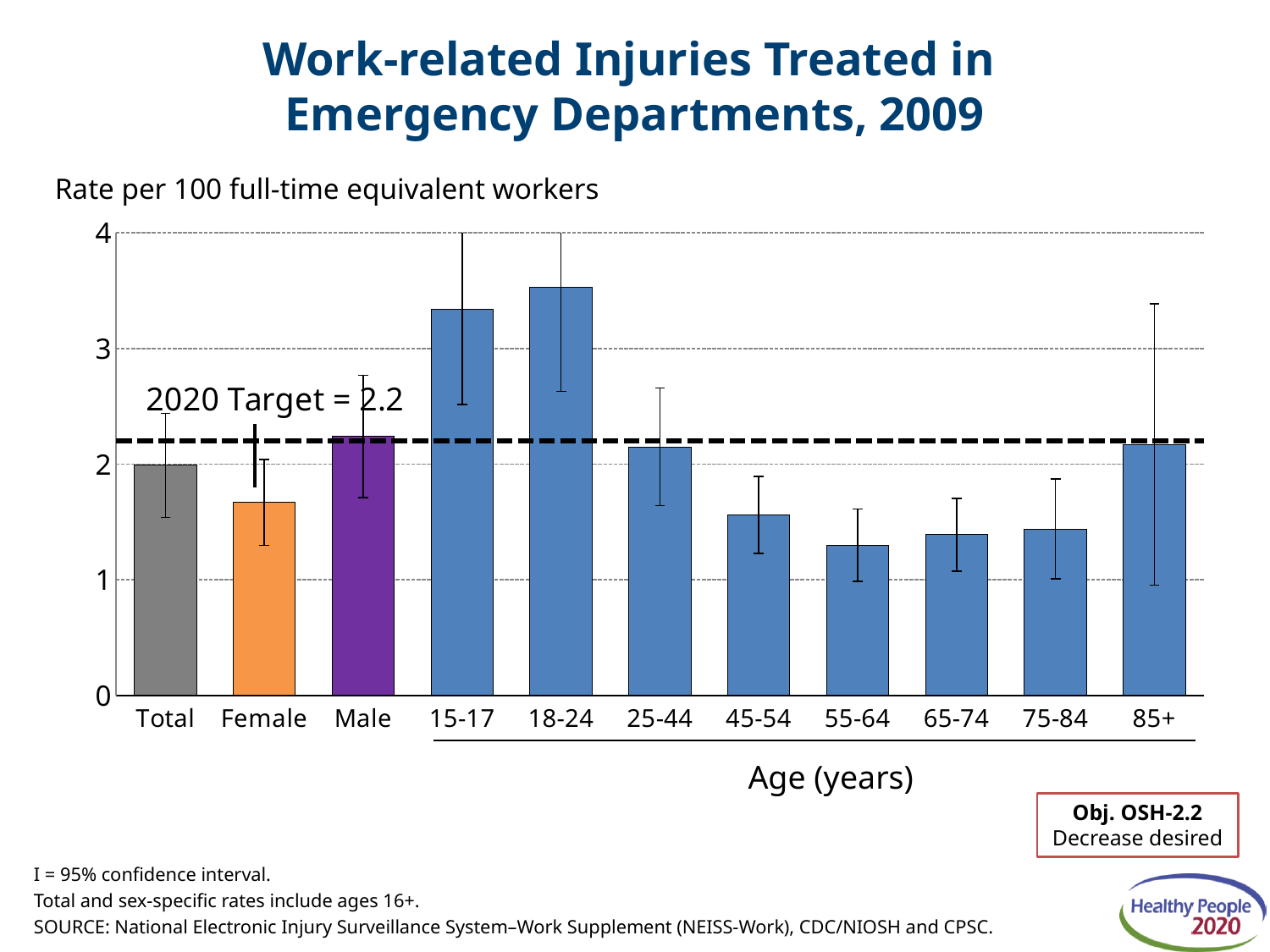
How many bars are plotted on the chart? 11 Is the value for ages 55-64 greater or less than 1? greater Is the value for Female greater or less than 2? less Which is higher, the rate for ages 15-17 or the rate for ages 25-44? 15-17 Is the value for ages 18-24 greater or less than 3? greater What unit is the rate measured in, according to the axis label? Rate per 100 full-time equivalent workers What is the 2020 target value shown by the dashed line on the chart? 2.2 Which age group has the highest rate of work-related injuries treated in emergency departments? 18-24 What kind of chart is shown on the slide? bar chart Which is higher, the rate for Male or the rate for Female? Male